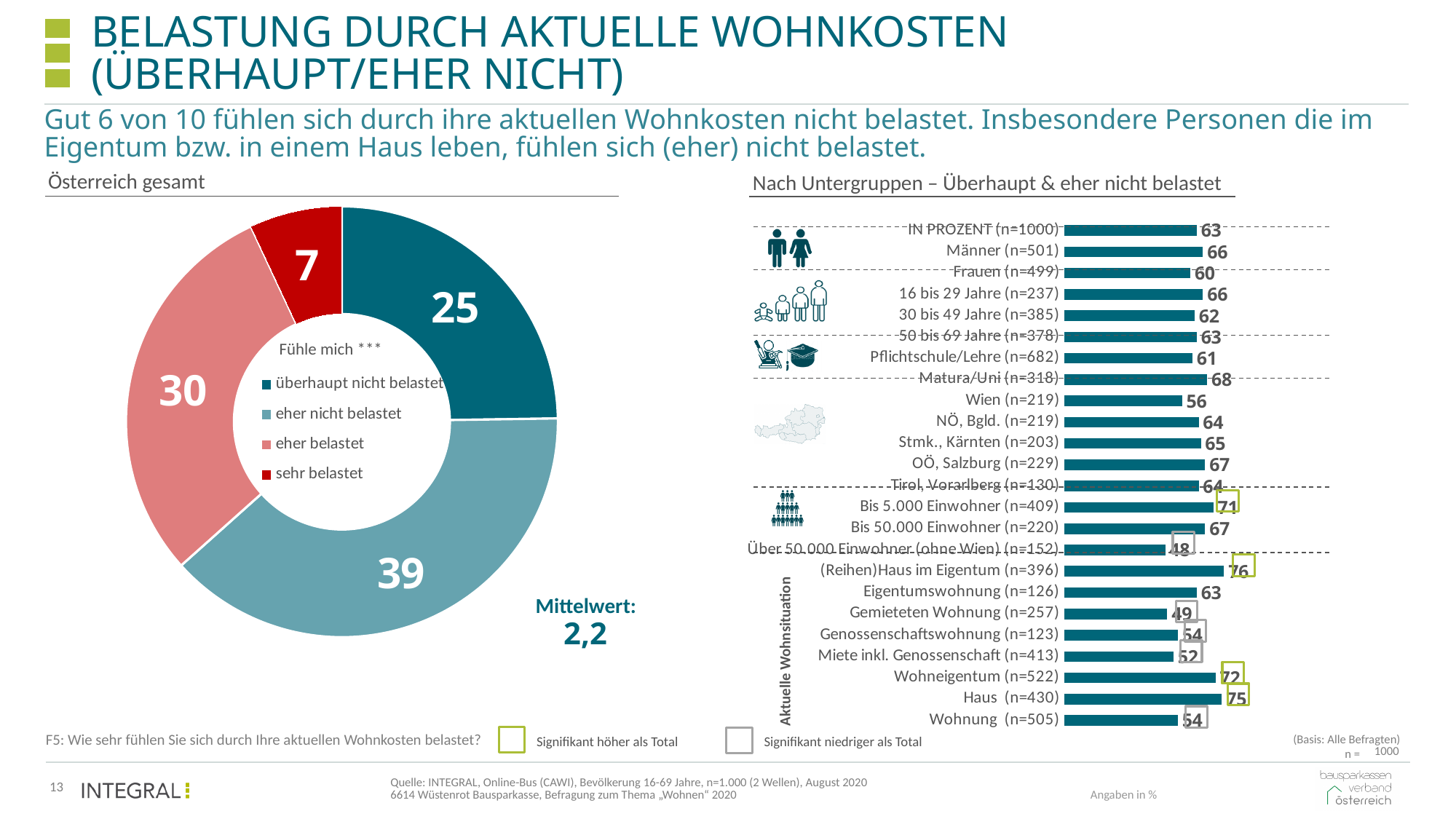
In the bar chart 'Nach Untergruppen', which subgroup has the lowest value? Über 50.000 Einwohner (ohne Wien) (n=152) What kind of chart is 'Nach Untergruppen – Überhaupt & eher nicht belastet'? bar chart In the bar chart 'Nach Untergruppen', which subgroup has the highest value? (Reihen)Haus im Eigentum (n=396) In the bar chart 'Nach Untergruppen', which has the larger value: Haus (n=430) or Wohnung (n=505)? Haus (n=430) In the donut chart 'Österreich gesamt', what percentage answered 'sehr belastet'? 7 In the donut chart 'Österreich gesamt', what is the Mittelwert shown? 2,2 In the donut chart 'Österreich gesamt', what percentage of respondents answered 'eher nicht belastet'? 39 In the donut chart 'Österreich gesamt', which category has the largest share? eher nicht belastet In the donut chart 'Österreich gesamt', how many categories does the legend list? 4 In the bar chart 'Nach Untergruppen', what is the value for Wien (n=219)? 56 In the bar chart 'Nach Untergruppen', what is the difference between the values for Männer (n=501) and Frauen (n=499)? 6 In the donut chart 'Österreich gesamt', what is the combined share of 'überhaupt nicht belastet' and 'eher nicht belastet'? 64